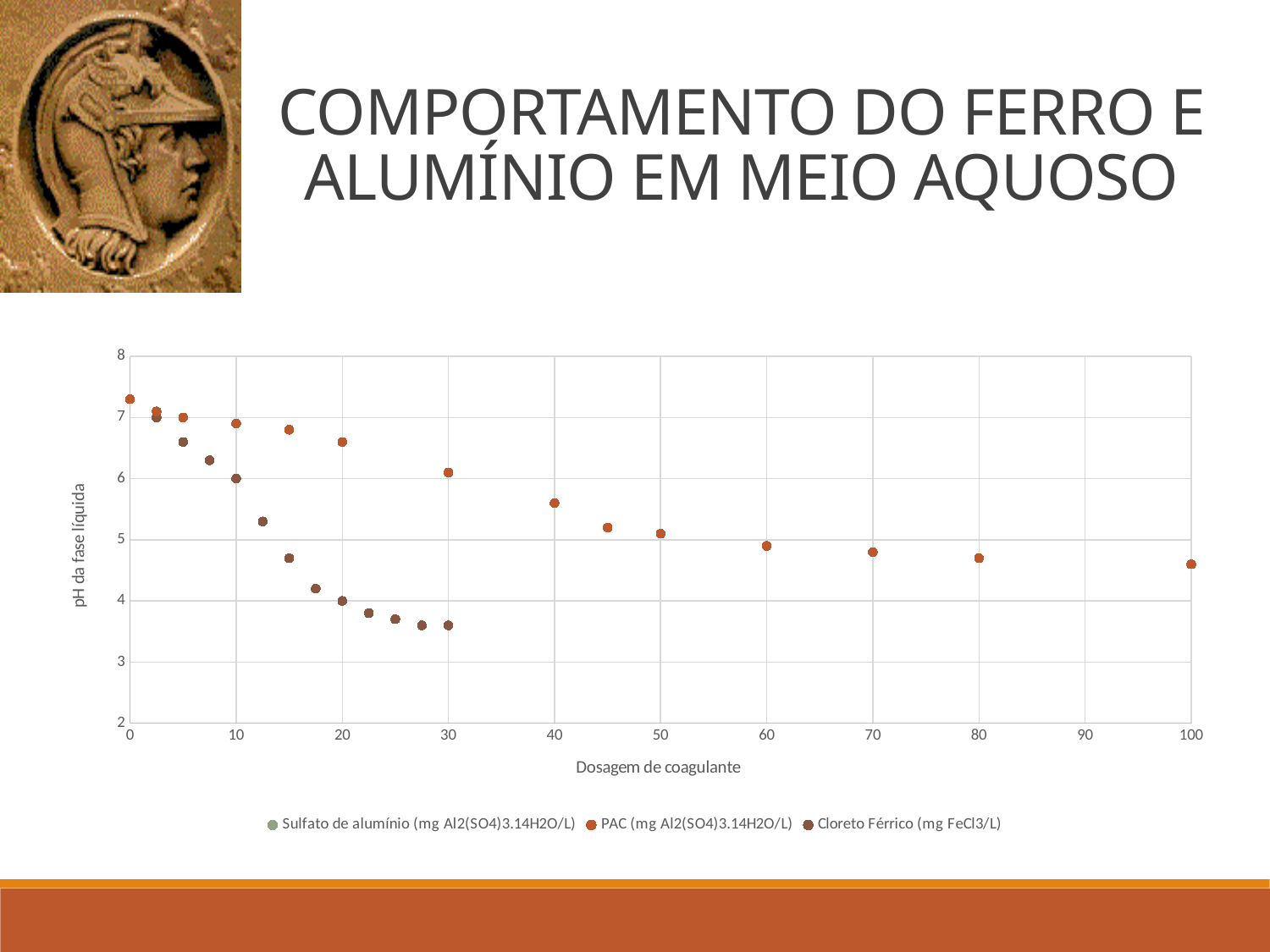
Is the PAC value at a dosage of 100 greater or less than 5? less Is the PAC value at a dosage of 40 greater or less than 5? greater How many series does the chart legend list? 3 What is the title of the chart's x axis? Dosagem de coagulante What is the highest value shown on the chart's x axis? 100 At a dosage of 20, which series has the higher pH value, PAC or Cloreto Férrico? PAC What is the title of the chart's y axis? pH da fase líquida Is the Cloreto Férrico value at a dosage of 30 greater or less than 4? less What kind of chart is shown on the slide? scatter chart Do the Cloreto Férrico values rise or fall as the coagulant dosage increases along the x axis? fall Do the PAC values rise or fall as the coagulant dosage increases along the x axis? fall